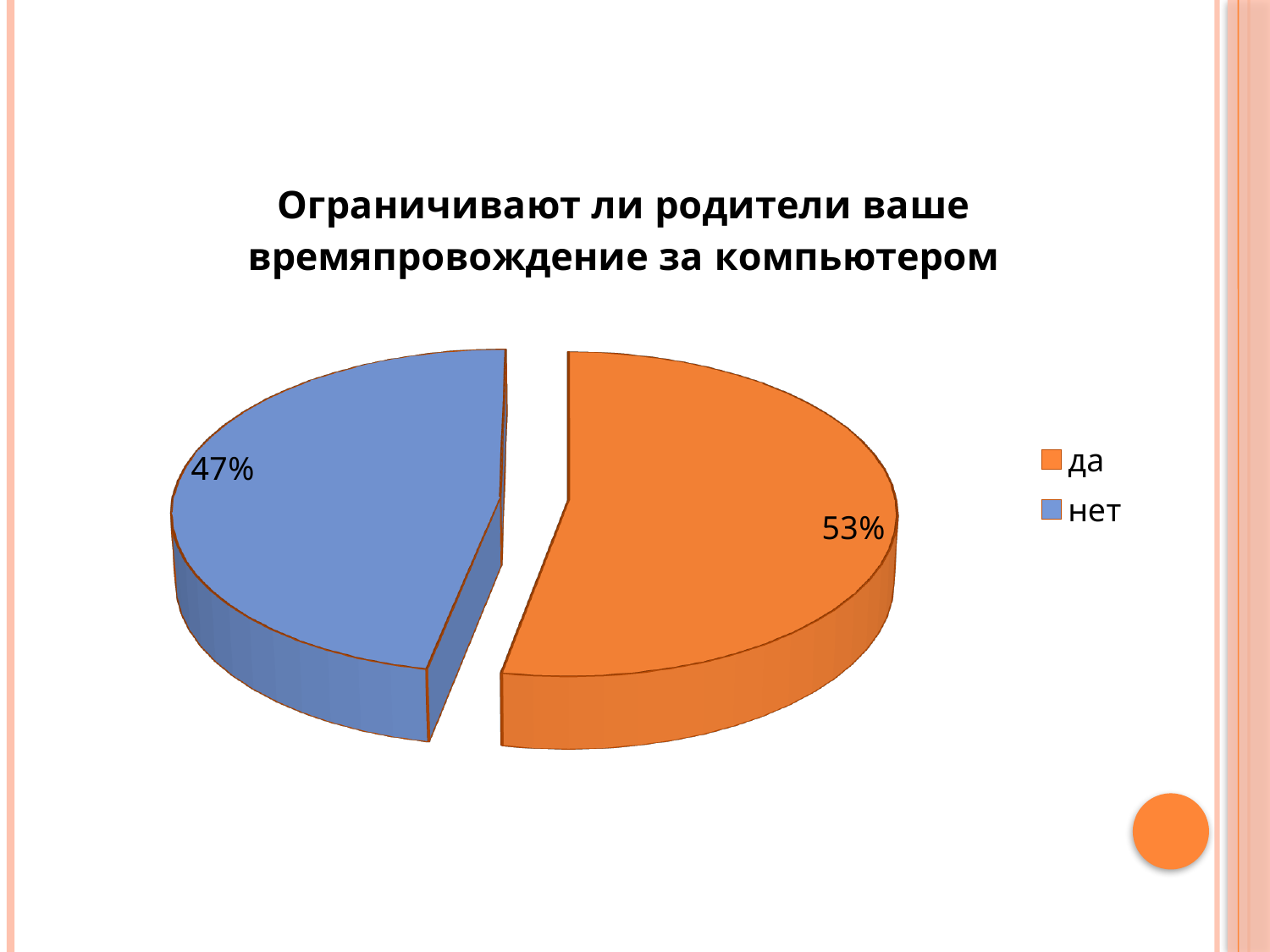
How many slices does the pie chart have? 2 What colour is the "да" slice? orange What percentage of the pie is labelled "да"? 53% What percentage of the pie is labelled "нет"? 47% What kind of chart is shown on the slide? pie chart What is the difference in percentage points between the "да" and "нет" slices? 6 What is the title of the chart? Ограничивают ли родители ваше времяпровождение за компьютером What share of the pie does the "нет" slice represent? 47% Which slice is larger, "да" or "нет"? да Which category has the smallest share of the pie? нет Which category has the largest share of the pie? да